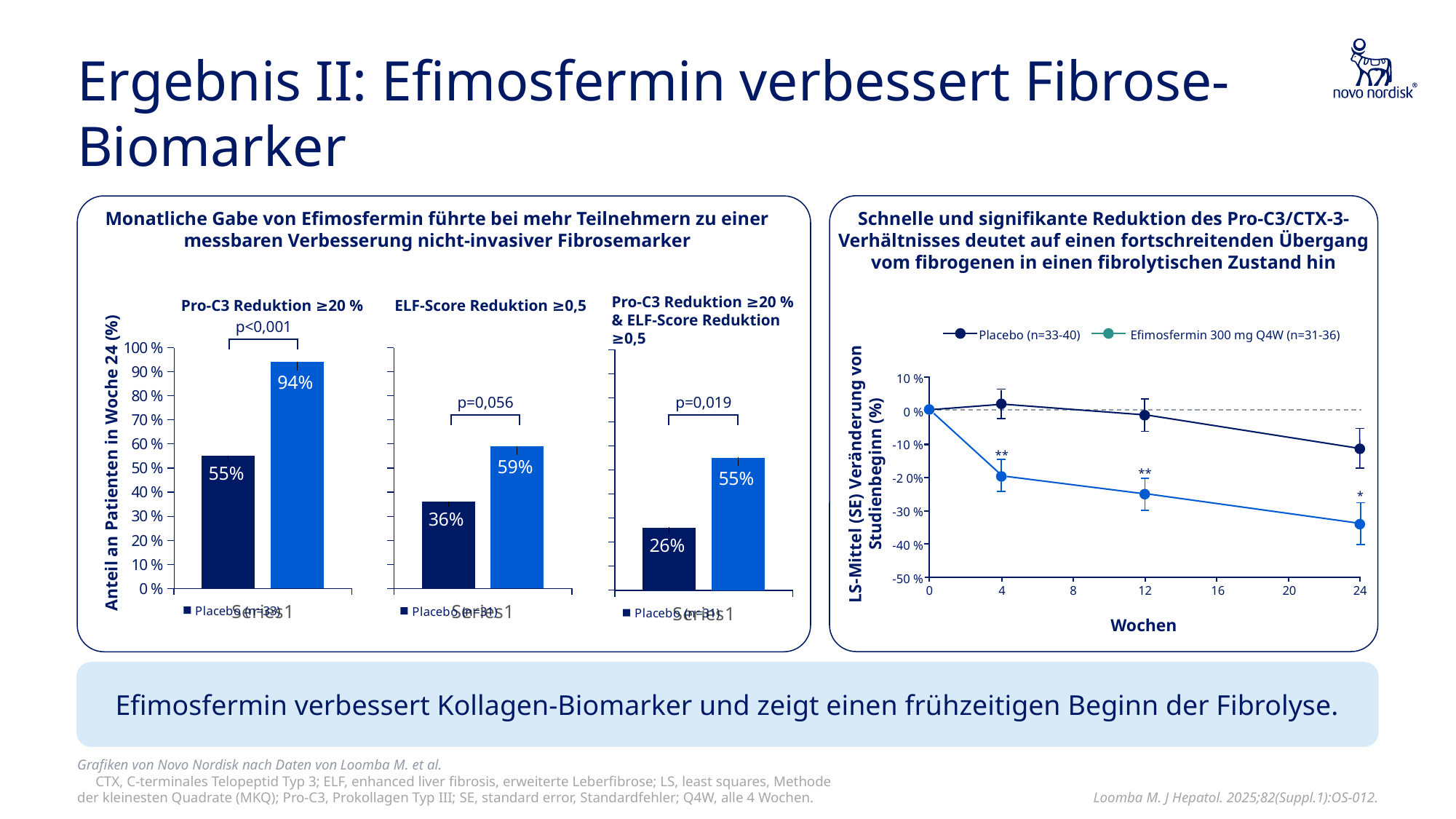
In the 'Pro-C3 Reduktion ≥20 % & ELF-Score Reduktion ≥0,5' bar chart, which bar is higher, the dark blue or the light blue bar? light blue How many series does the legend of the right-hand line chart list? 2 In the 'Pro-C3 Reduktion ≥20 %' bar chart, what is the value of the Placebo (dark blue) bar? 55% In the 'ELF-Score Reduktion ≥0,5' bar chart, what is the difference between the light blue bar and the dark blue bar? 23% In the 'Pro-C3 Reduktion ≥20 %' bar chart, what is the value of the light blue bar? 94% In the 'Pro-C3 Reduktion ≥20 % & ELF-Score Reduktion ≥0,5' bar chart, what is the value of the light blue bar? 55% In the 'Pro-C3 Reduktion ≥20 %' bar chart, what p-value is shown above the bars? p<0,001 In the right-hand line chart, is the value for Placebo at week 24 greater or less than -20 %? greater What kind of chart is shown in the right-hand panel (Pro-C3/CTX-3 ratio)? line chart In the 'ELF-Score Reduktion ≥0,5' bar chart, what is the value of the Placebo (dark blue) bar? 36% In the right-hand line chart, does the Efimosfermin 300 mg Q4W line rise or fall from week 0 to week 24? fall In the right-hand line chart, is the value for Efimosfermin 300 mg Q4W at week 24 greater or less than -30 %? less